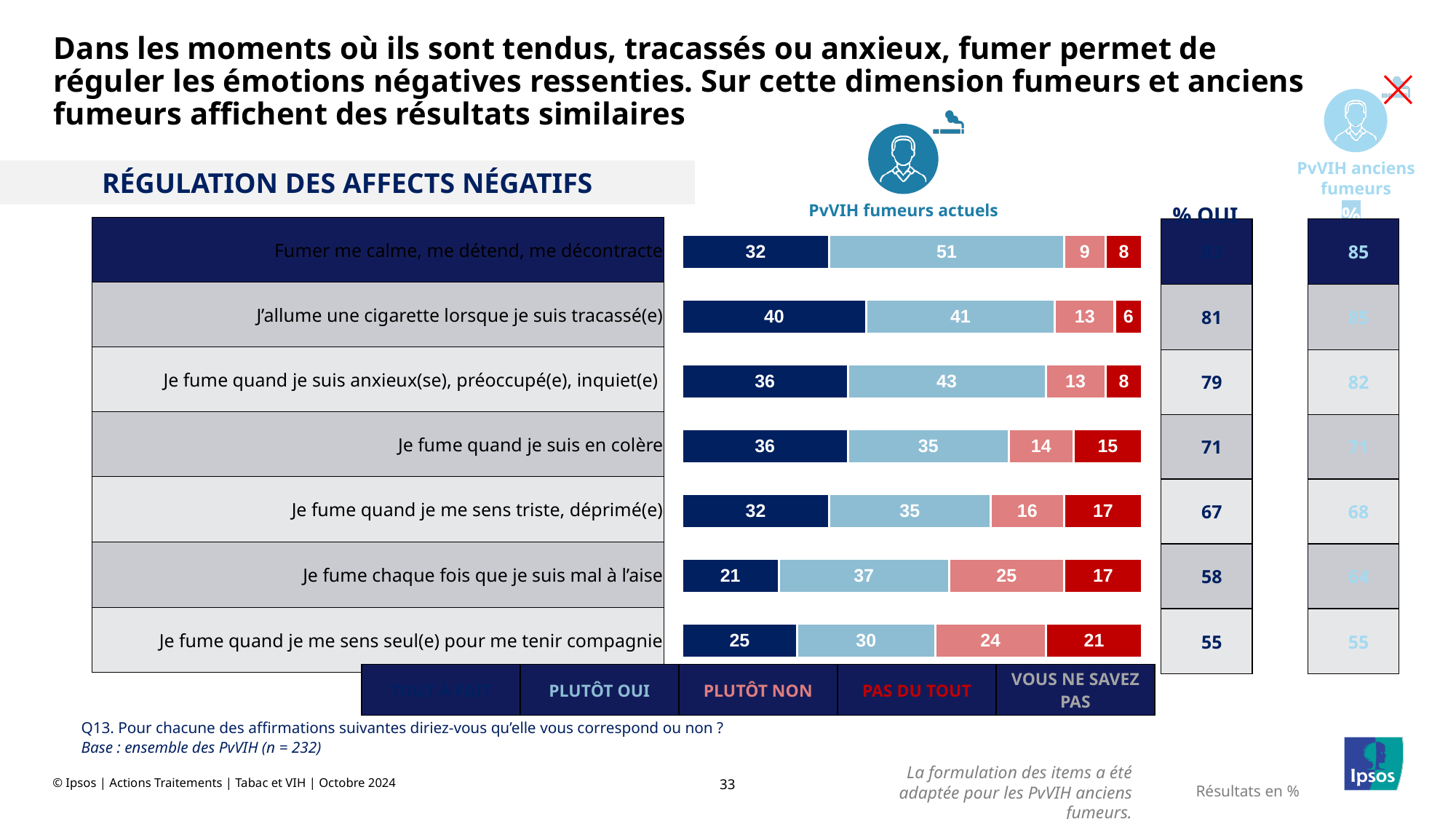
What is the total of the four labelled segments for "Je fume quand je me sens seul(e) pour me tenir compagnie"? 100 What is the "% OUI" value for "Je fume quand je me sens triste, déprimé(e)"? 67 Which has the larger "Plutôt oui" value: "Je fume quand je suis anxieux(se), préoccupé(e), inquiet(e)" or "Je fume quand je suis en colère"? Je fume quand je suis anxieux(se), préoccupé(e), inquiet(e) What is the difference between the "Plutôt non" values for "Je fume chaque fois que je suis mal à l'aise" and "Je fume quand je suis en colère"? 11 What is the "Plutôt oui" value for "Fumer me calme, me détend, me décontracte"? 51 Which statement has the highest "Tout à fait" value? J'allume une cigarette lorsque je suis tracassé(e) How many statements are plotted in the chart? 7 What is the "Pas du tout" value for "Je fume quand je me sens seul(e) pour me tenir compagnie"? 21 How many response categories does the legend list? 5 Which statement has the lowest "Tout à fait" value? Je fume chaque fois que je suis mal à l'aise What is the "Tout à fait" value for "Je fume quand je suis en colère"? 36 What kind of chart is shown on the slide? Stacked bar chart